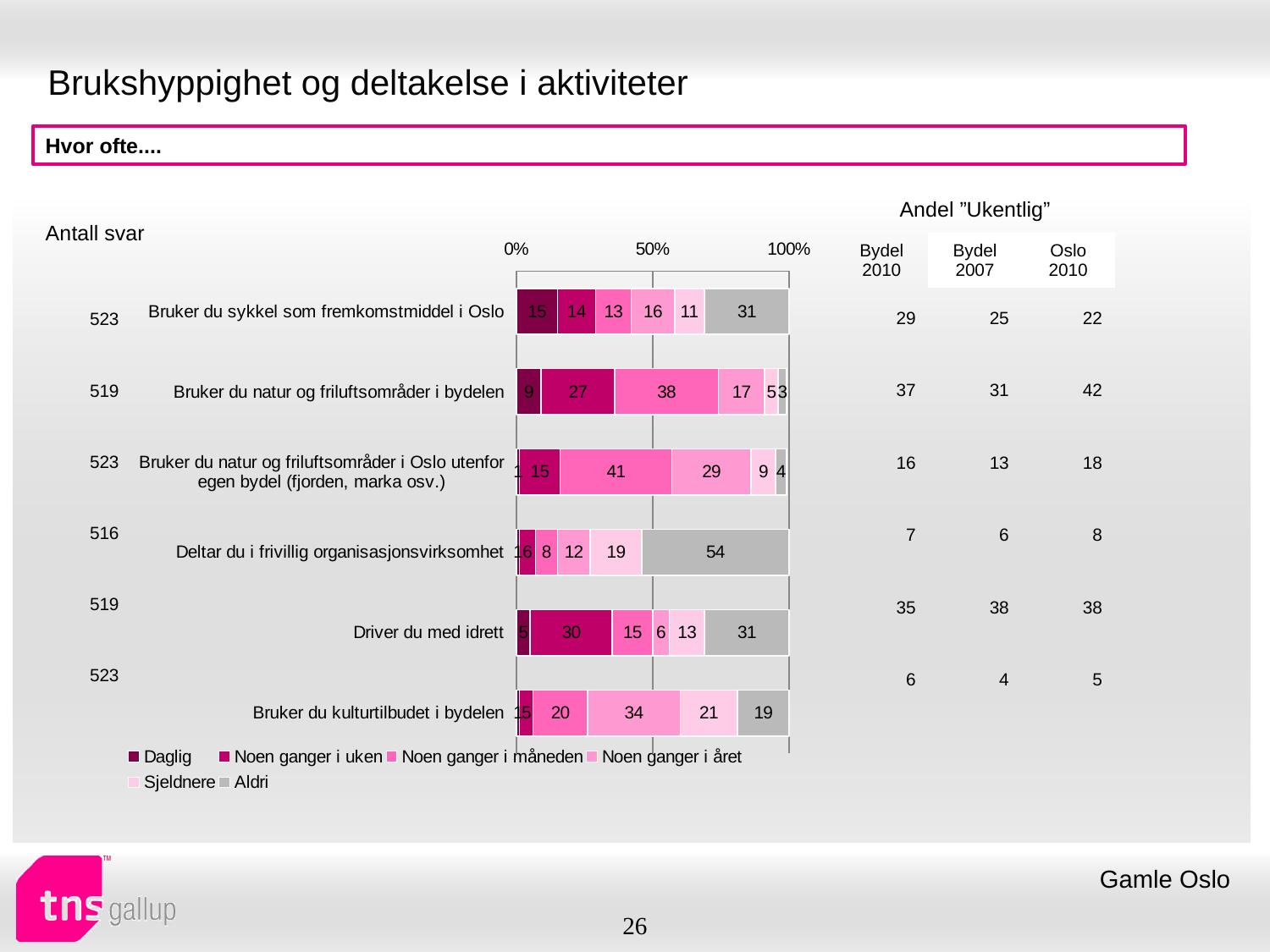
What is the difference between the "Aldri" values for "Bruker du sykkel som fremkomstmiddel i Oslo" and "Bruker du kulturtilbudet i bydelen"? 12 What is the "Noen ganger i året" value for "Bruker du kulturtilbudet i bydelen"? 34 Which has the larger "Noen ganger i uken" value: "Driver du med idrett" or "Bruker du sykkel som fremkomstmiddel i Oslo"? Driver du med idrett What kind of chart is shown on the slide? Stacked bar chart Which activity has the lowest "Aldri" share? Bruker du natur og friluftsområder i bydelen How many series does the legend list? 6 What is the first entry in the chart legend? Daglig Which activity has the highest "Aldri" share? Deltar du i frivillig organisasjonsvirksomhet What is the "Daglig" value for "Bruker du sykkel som fremkomstmiddel i Oslo"? 15 What is the value for "Noen ganger i måneden" for "Bruker du natur og friluftsområder i bydelen"? 38 How many activities (categories) are shown in the chart? 6 What percentage answered "Aldri" for "Deltar du i frivillig organisasjonsvirksomhet"? 54